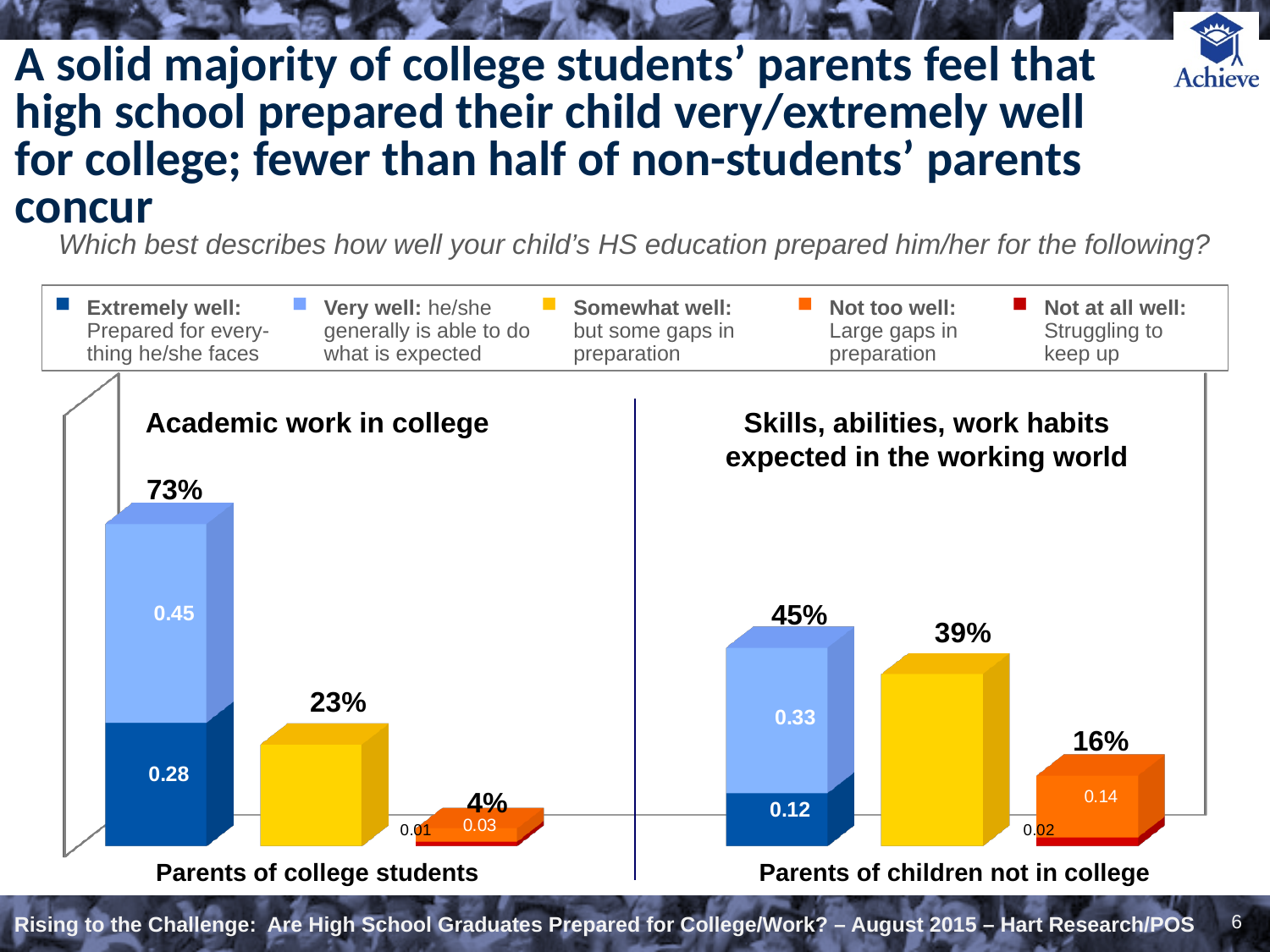
How many categories does the legend at the top of the chart list? 5 In the 'Skills, abilities, work habits expected in the working world' panel, what is the value for 'Somewhat well'? 39% In the 'Academic work in college' panel, which bar is the lowest? Not too well/Not at all well (4%) In the 'Academic work in college' panel, what is the value for 'Somewhat well'? 23% What kind of chart is shown on the slide? bar chart In the 'Academic work in college' panel, what is the combined value labelled above the extremely well/very well stacked bar? 73% What is the difference between the 'Somewhat well' values in the two panels (39% and 23%)? 16% In the 'Skills, abilities, work habits expected in the working world' panel, what is the value for the 'Not too well' segment? 0.14 In the 'Academic work in college' panel, what is the value for the 'Very well' segment? 0.45 Which panel has the larger combined extremely well/very well value: 'Academic work in college' or 'Skills, abilities, work habits expected in the working world'? Academic work in college In the 'Academic work in college' panel, what is the value for the 'Extremely well' segment? 0.28 In the 'Skills, abilities, work habits expected in the working world' panel, what is the combined value labelled above the extremely well/very well stacked bar? 45%